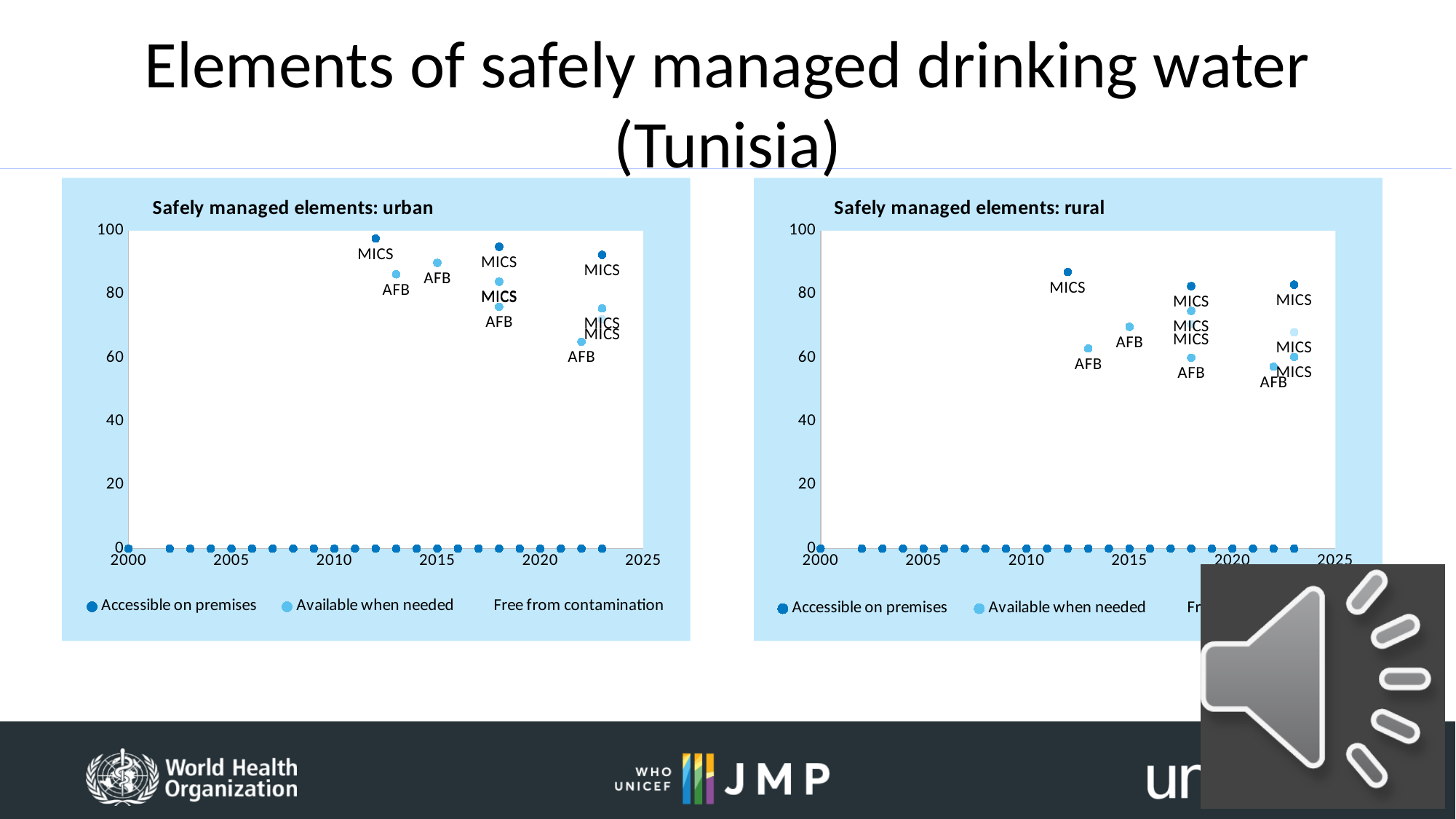
In the 'Safely managed elements: rural' chart, is the 'Available when needed' value for the 2013 AFB point greater or less than 80? less What are the three series listed in the legend of the 'Safely managed elements: urban' chart? Accessible on premises, Available when needed, Free from contamination In the 'Safely managed elements: urban' chart, do the 'Accessible on premises' MICS values rise or fall from 2012 to 2023? fall In the 'Safely managed elements: urban' chart, which is larger for 2023: the 'Accessible on premises' MICS value or the 'Available when needed' MICS value? Accessible on premises In the 'Safely managed elements: urban' chart, is the 'Accessible on premises' value for the 2023 MICS point greater or less than 80? greater In the 'Safely managed elements: rural' chart, is the 'Available when needed' value for the 2013 AFB point greater or less than 40? greater In the 'Safely managed elements: rural' chart, which is larger for 2012: the 'Accessible on premises' MICS value or the 2013 'Available when needed' AFB value? Accessible on premises (2012 MICS) How many series does the legend of the 'Safely managed elements: urban' chart list? 3 What is the title of the chart on the right of the slide? Safely managed elements: rural What kind of chart is the 'Safely managed elements: urban' chart? Scatter chart